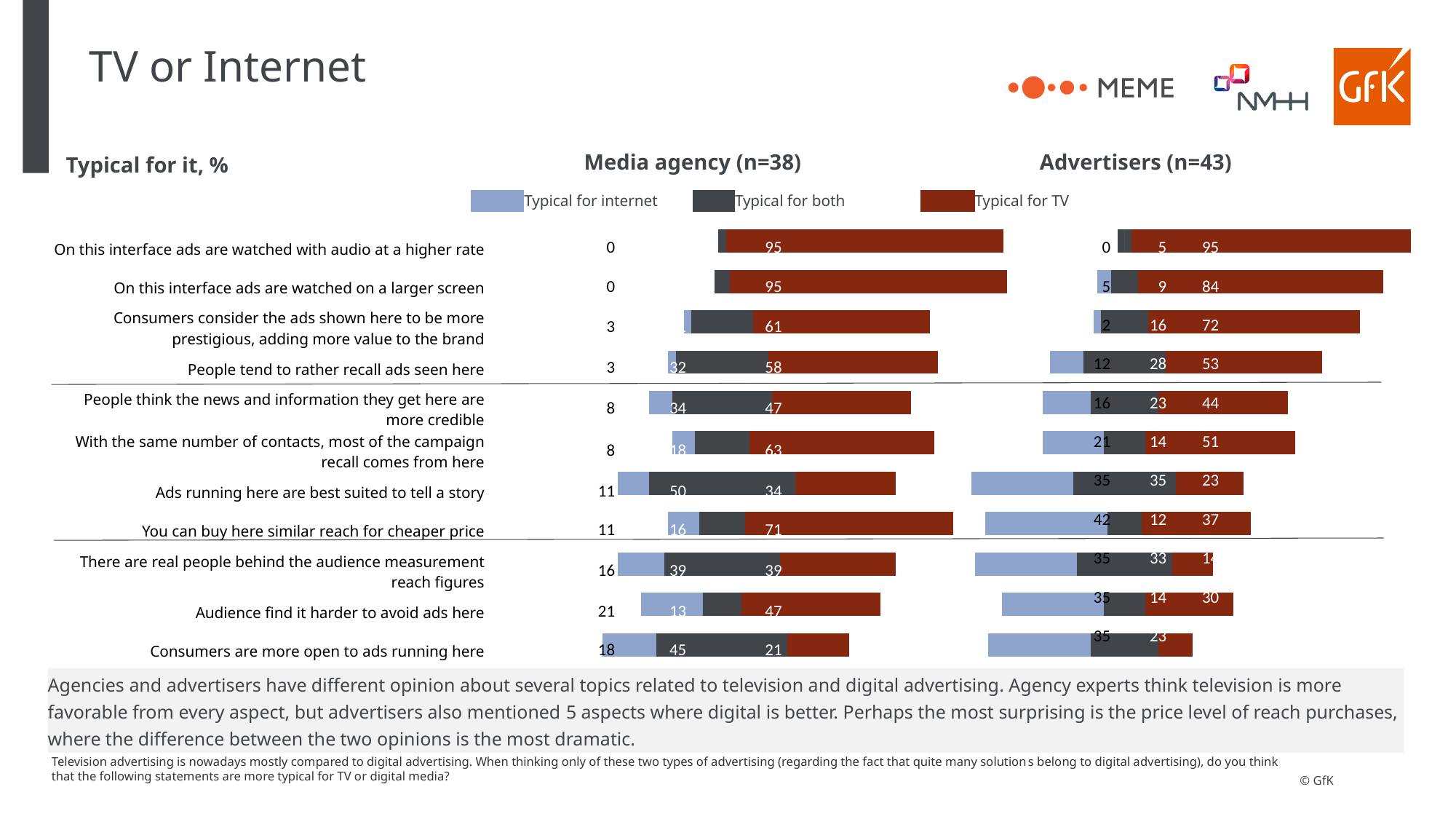
In the Media agency (n=38) chart, for 'Consumers are more open to ads running here', which is larger: Typical for both or Typical for TV? Typical for both In the Media agency (n=38) chart, what is the total of the stacked bar for 'Ads running here are best suited to tell a story'? 95 In the Advertisers (n=43) chart, what is the difference between the Typical for internet and Typical for TV values for 'You can buy here similar reach for cheaper price'? 5 For 'You can buy here similar reach for cheaper price', how much higher is the Typical for TV value in the Media agency chart than in the Advertisers chart? 34 In the Advertisers (n=43) chart, what is the Typical for internet value for 'You can buy here similar reach for cheaper price'? 42 How many series does the legend list? 3 In the Media agency (n=38) chart, what is the Typical for internet value for 'Audience find it harder to avoid ads here'? 21 In the Advertisers (n=43) chart, what is the Typical for both value for 'People tend to rather recall ads seen here'? 28 How many statements (categories) are listed on the slide's charts? 11 In the Media agency (n=38) chart, which statement has the lowest Typical for TV value? Consumers are more open to ads running here In the Advertisers (n=43) chart, which statement has the highest Typical for internet value? You can buy here similar reach for cheaper price In the Media agency (n=38) chart, what is the Typical for TV value for 'You can buy here similar reach for cheaper price'? 71